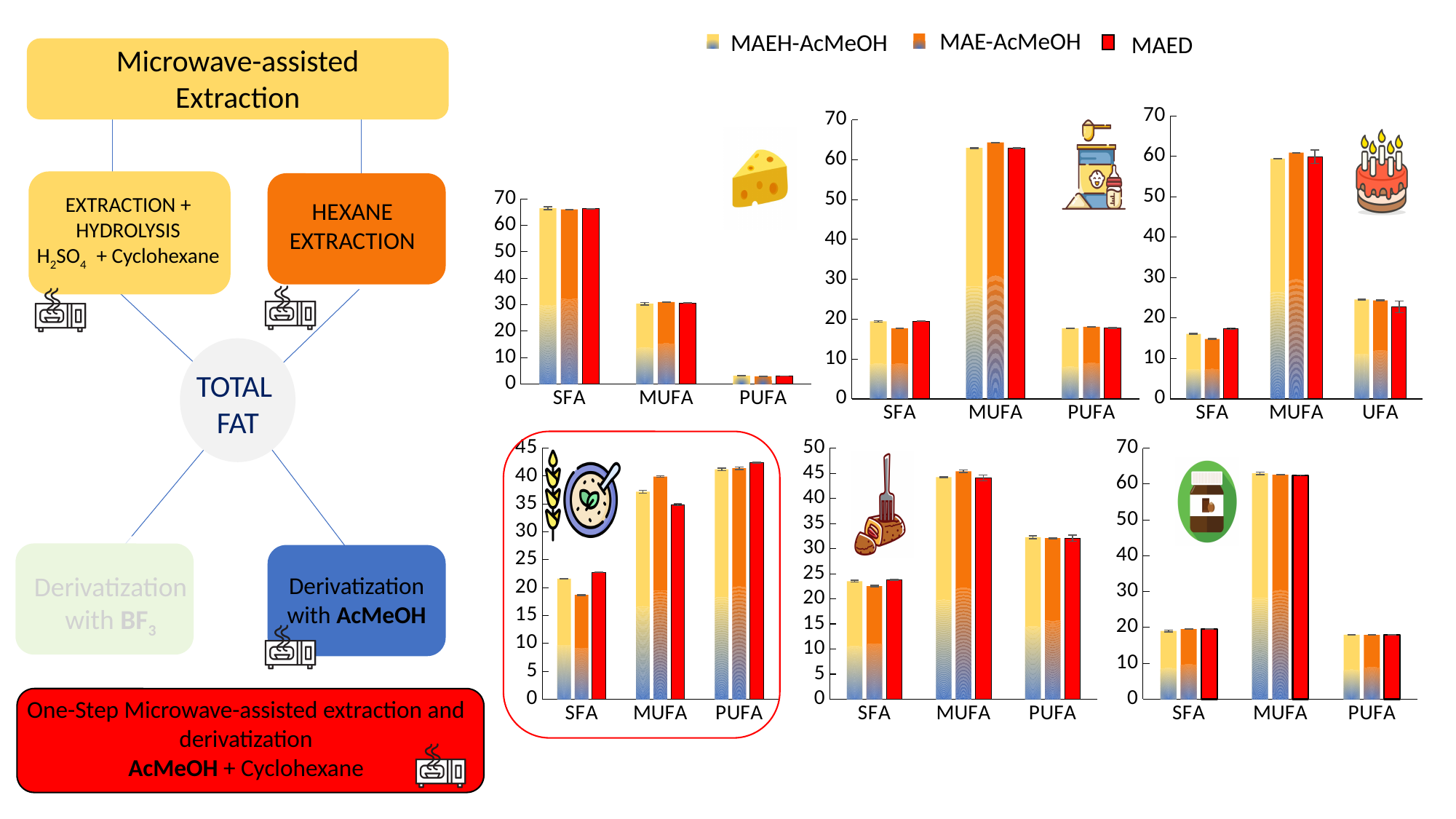
In the top-left chart (cheese icon), which category has the highest values? SFA What are the three series named in the legend? MAEH-AcMeOH, MAE-AcMeOH, MAED In the top-right chart (cake icon), which category has the highest values? MUFA How many series does the legend at the top of the slide list? 3 In the bottom-left chart outlined in red (cereal icon), which is larger for SFA: MAEH-AcMeOH or MAE-AcMeOH? MAEH-AcMeOH In the bottom-right chart (supplement bottle icon), which category has the highest values? MUFA In the bottom-middle chart (meat icon), is the MAED value for PUFA greater or less than 30? greater In the top-left chart (cheese icon), is the MAED value for SFA greater or less than 60? greater What kind of chart is the chart with the cheese icon in the top-left of the chart area? bar chart In the top-left chart (cheese icon), which category has the lowest values? PUFA In the bottom-left chart outlined in red (cereal icon), do the values rise or fall from SFA to PUFA along the x axis? rise In the top-right chart (cake icon), what are the three categories on the x axis? SFA, MUFA, UFA